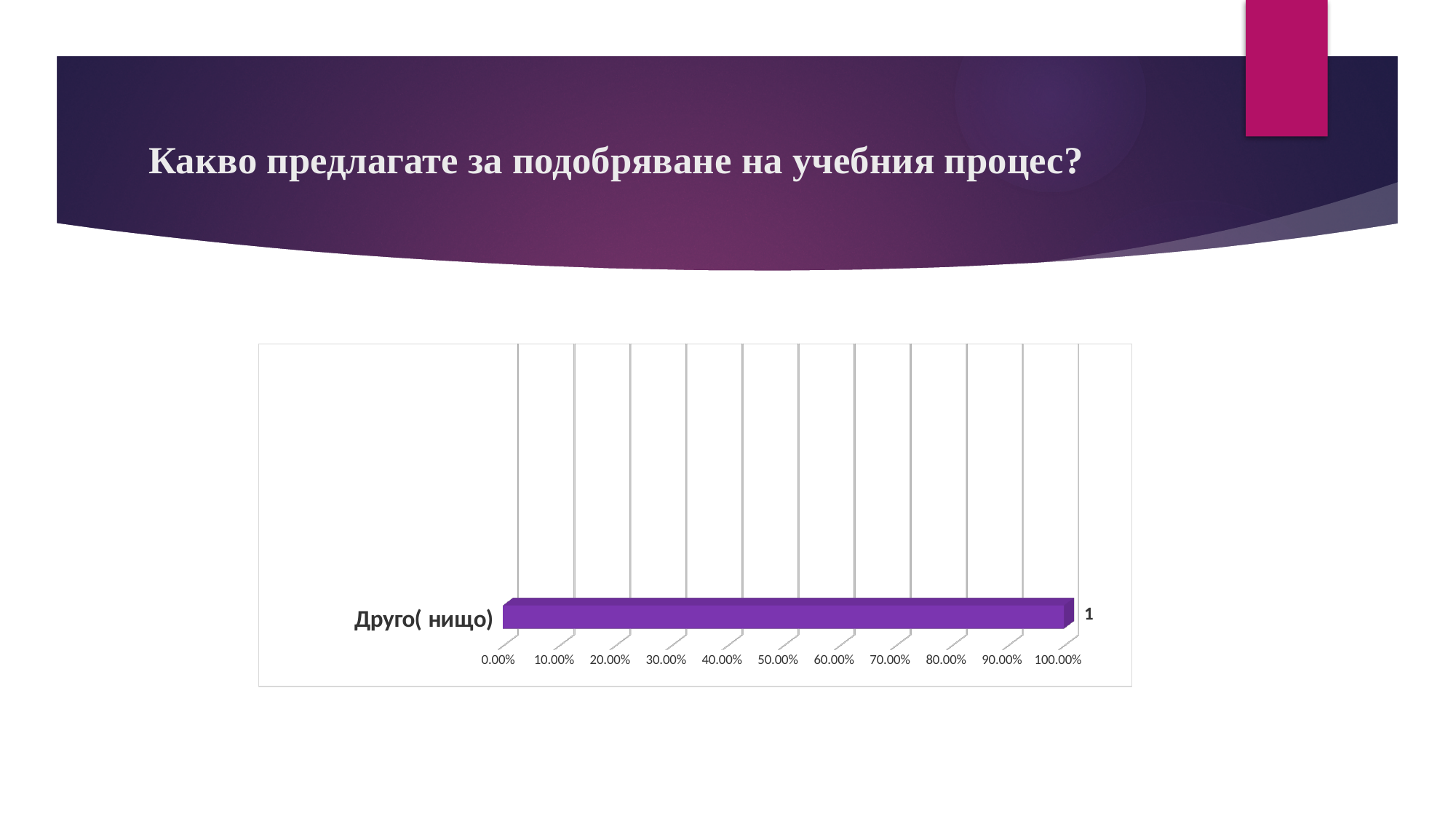
Is the bar for "Друго( нищо)" greater or less than 50.00% on the axis? greater What is the data label shown for the category "Друго( нищо)"? 1 How many categories are plotted in the chart? 1 What is the title of the slide containing the chart? Какво предлагате за подобряване на учебния процес? What is the highest value shown on the horizontal axis of the chart? 100.00% Is the bar for "Друго( нищо)" greater or less than 90.00% on the axis? greater What is the label of the only category in the chart? Друго( нищо) What kind of chart is shown on the slide? bar chart